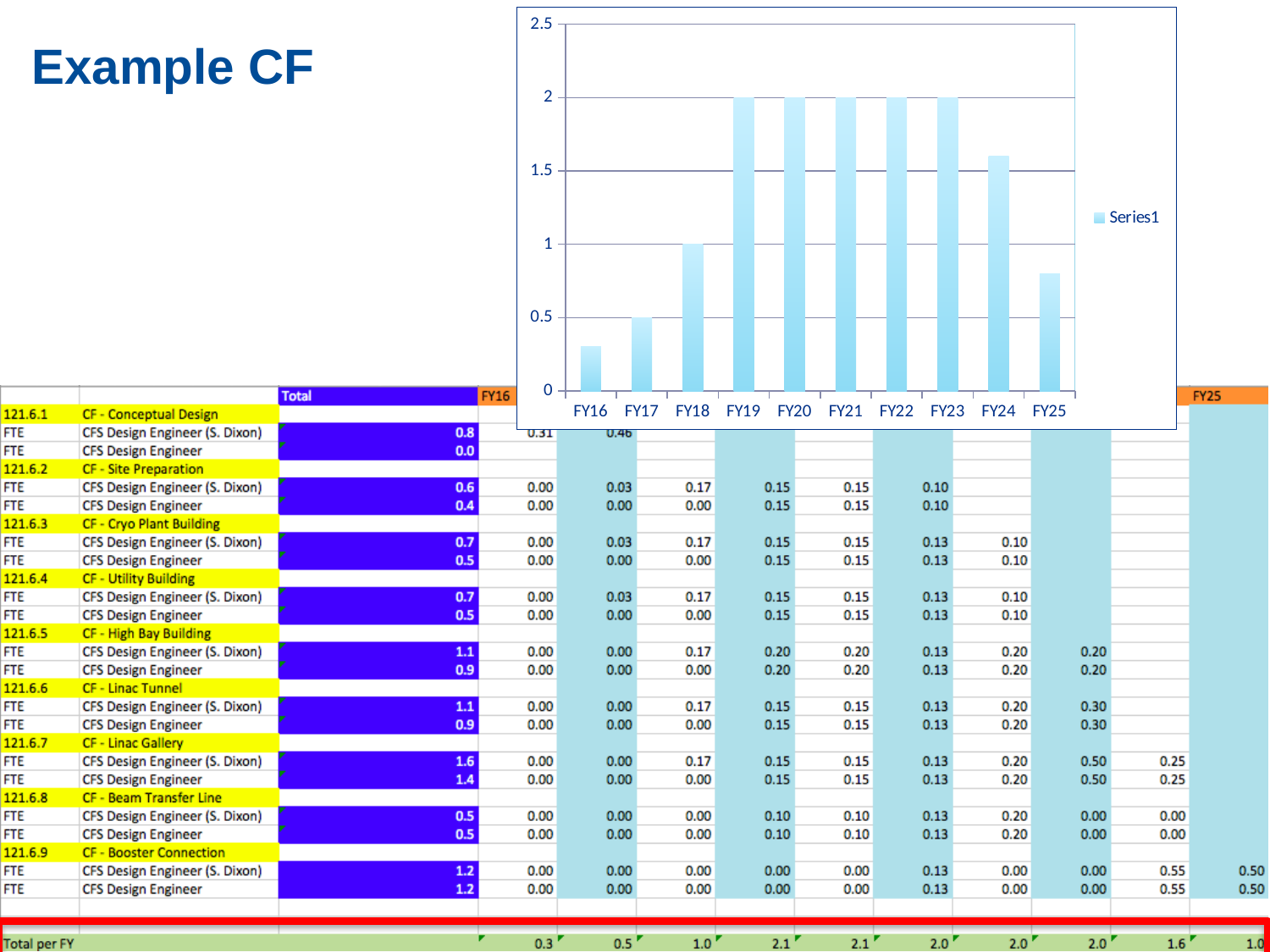
Is the value for FY25 greater or less than 1? less Which has the larger value in the chart, FY18 or FY24? FY24 Is the value for FY16 greater or less than 0.5? less How many fiscal years are plotted on the x axis of the chart? 10 What is the value for FY18 in the chart? 1 Do the values rise or fall from FY16 to FY19 in the chart? rise What is the name of the series shown in the chart's legend? Series1 What type of chart is shown on the slide? bar chart How many series does the chart's legend list? 1 Is the value for FY24 greater or less than 1.5? greater What is the value for FY17 in the chart? 0.5 Which fiscal year has the lowest bar in the chart? FY16